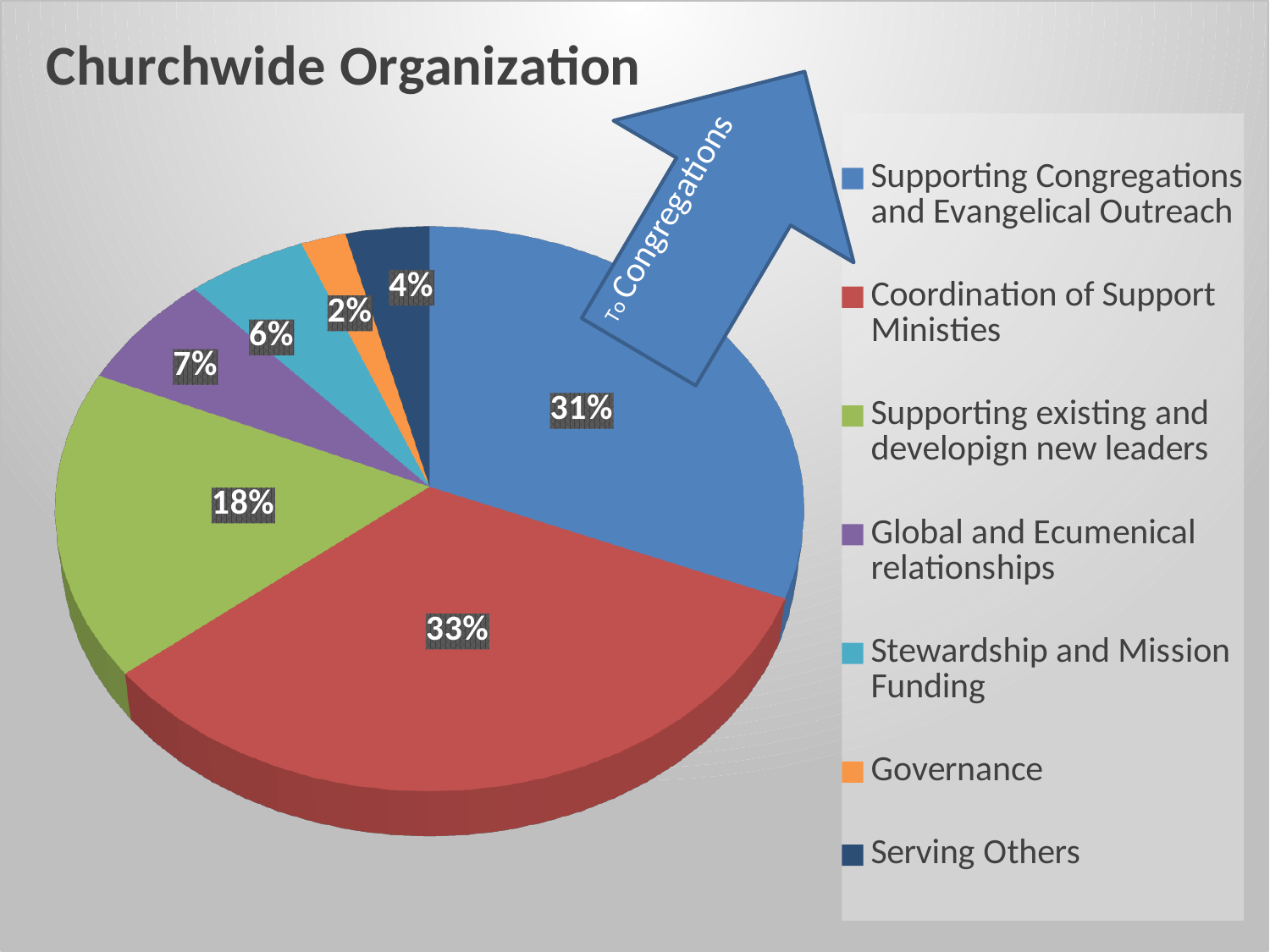
What percentage is shown for Global and Ecumenical relationships? 7% What percentage is shown for Supporting existing and developign new leaders? 18% What share of the pie does Supporting Congregations and Evangelical Outreach have? 31% How many categories does the pie chart have? 7 Which is larger, the slice for Stewardship and Mission Funding or the slice for Serving Others? Stewardship and Mission Funding What share of the pie does Coordination of Support Ministries have? 33% What percentage is shown for Governance? 2% Which category has the largest slice of the pie? Coordination of Support Ministries What is the title of the chart? Churchwide Organization Which category has the smallest slice of the pie? Governance What kind of chart is shown on the slide? Pie chart What is the difference in percentage points between Coordination of Support Ministries and Supporting Congregations and Evangelical Outreach? 2 percentage points